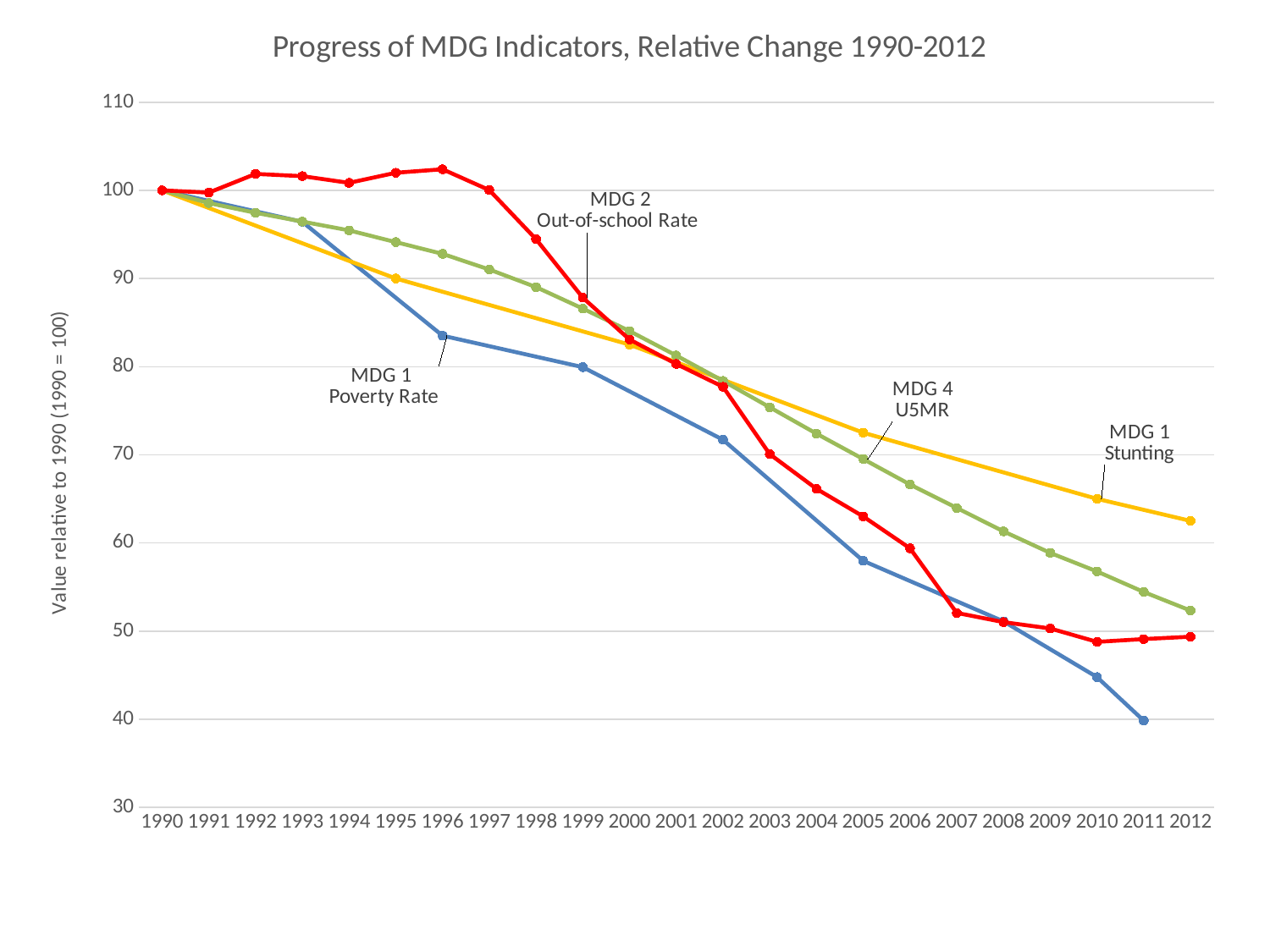
Is the value for MDG 1 Poverty Rate in 2011 greater or less than 50? less Do the values of the MDG 4 U5MR series rise or fall from 1990 to 2012? fall Is the value for MDG 2 Out-of-school Rate in 1996 greater or less than 100? greater How many years are shown along the x axis? 23 Which series has the highest value in 2012? MDG 1 Stunting How many series are plotted on the chart? 4 What is the value of the MDG 1 Poverty Rate series in 1990? 100 What is the label on the vertical axis of the chart? Value relative to 1990 (1990 = 100) What is the title of the chart? Progress of MDG Indicators, Relative Change 1990-2012 In 2010, which is higher: MDG 1 Poverty Rate or MDG 2 Out-of-school Rate? MDG 2 Out-of-school Rate Is the value for MDG 1 Stunting in 2012 greater or less than 70? less What kind of chart is shown on the slide? line chart